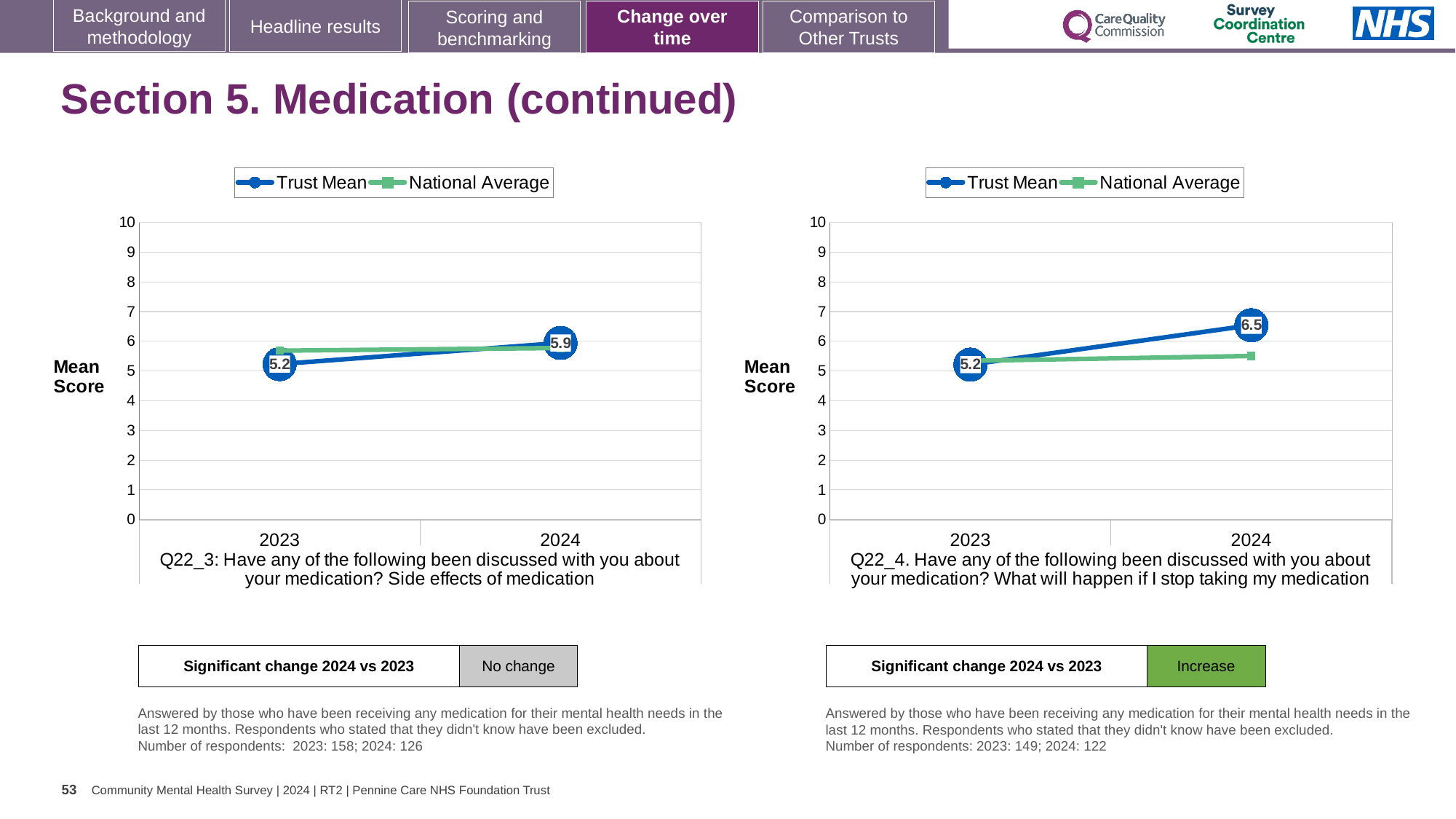
What type of chart is the right chart (Q22_4)? line chart In the right chart (Q22_4: What will happen if I stop taking my medication), what is the Trust Mean for 2023? 5.2 In the right chart (Q22_4), does the Trust Mean rise or fall from 2023 to 2024? rise In the right chart (Q22_4: What will happen if I stop taking my medication), what is the Trust Mean for 2024? 6.5 How many years are plotted on the x axis of the left chart (Q22_3)? 2 In the right chart (Q22_4), what is the difference between the Trust Mean for 2024 and 2023? 1.3 In the left chart (Q22_3: Side effects of medication), what is the Trust Mean for 2023? 5.2 In the left chart (Q22_3), which year has the higher Trust Mean, 2023 or 2024? 2024 How many series does the legend of the left chart list? 2 In the right chart (Q22_4), is the National Average for 2024 greater or less than 6? less In the left chart (Q22_3: Side effects of medication), what is the Trust Mean for 2024? 5.9 In the left chart (Q22_3), by how much did the Trust Mean change from 2023 to 2024? 0.7